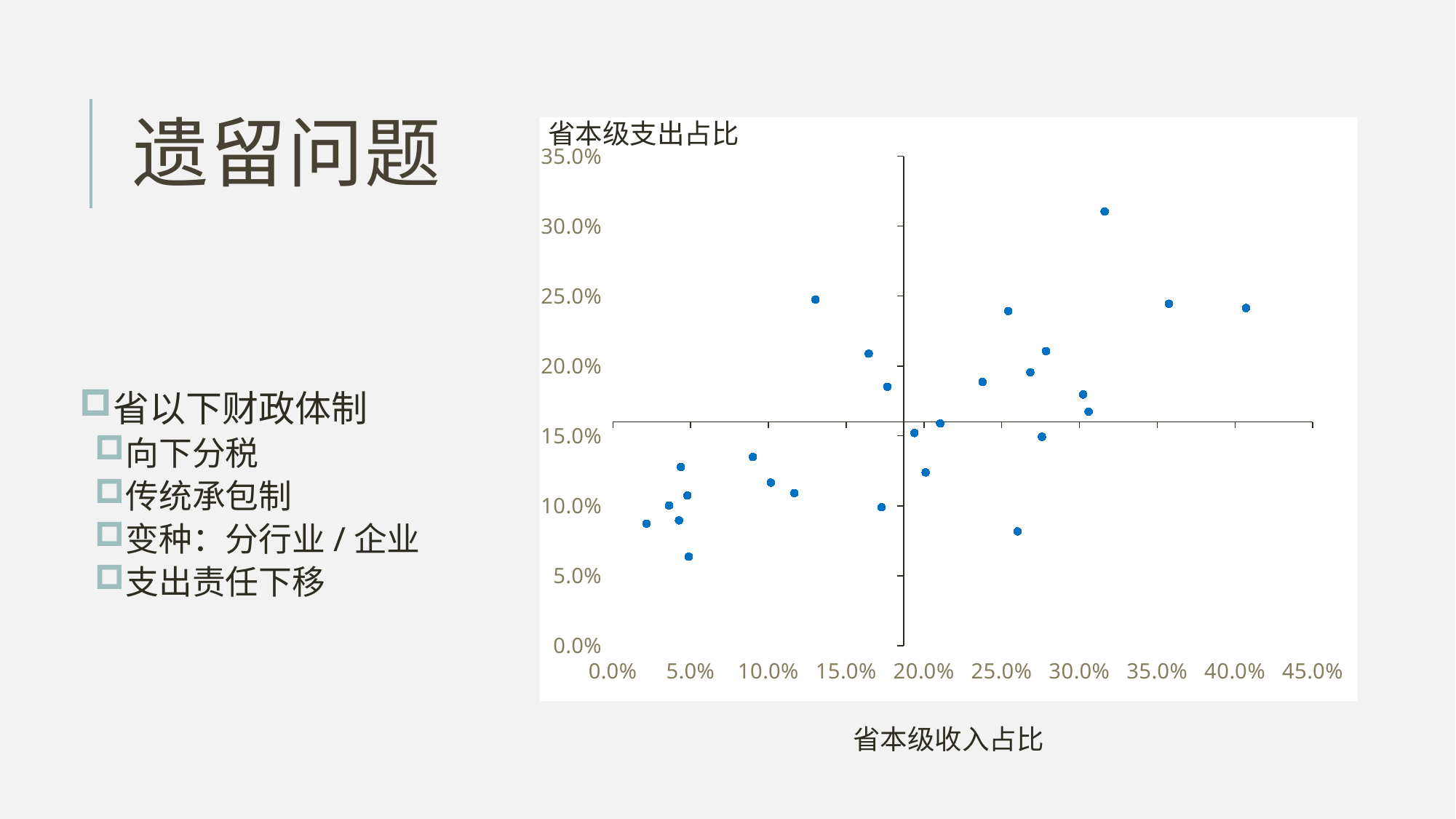
What is the highest value shown on the vertical axis of the chart? 35.0% What is the highest value shown on the horizontal axis of the chart? 45.0% What is the title of the horizontal axis of the chart? 省本级收入占比 Is the vertical-axis value of the highest point in the chart greater or less than 30.0%? greater Is the horizontal-axis value of the leftmost point in the chart greater or less than 5.0%? less What kind of chart is shown on the slide? Scatter chart Overall, do the points in the chart tend to rise or fall as the horizontal-axis value increases? rise Is the horizontal-axis value of the rightmost point in the chart greater or less than 35.0%? greater What is the title of the vertical axis of the chart? 省本级支出占比 What is the interval between consecutive tick labels on the vertical axis of the chart? 5.0%